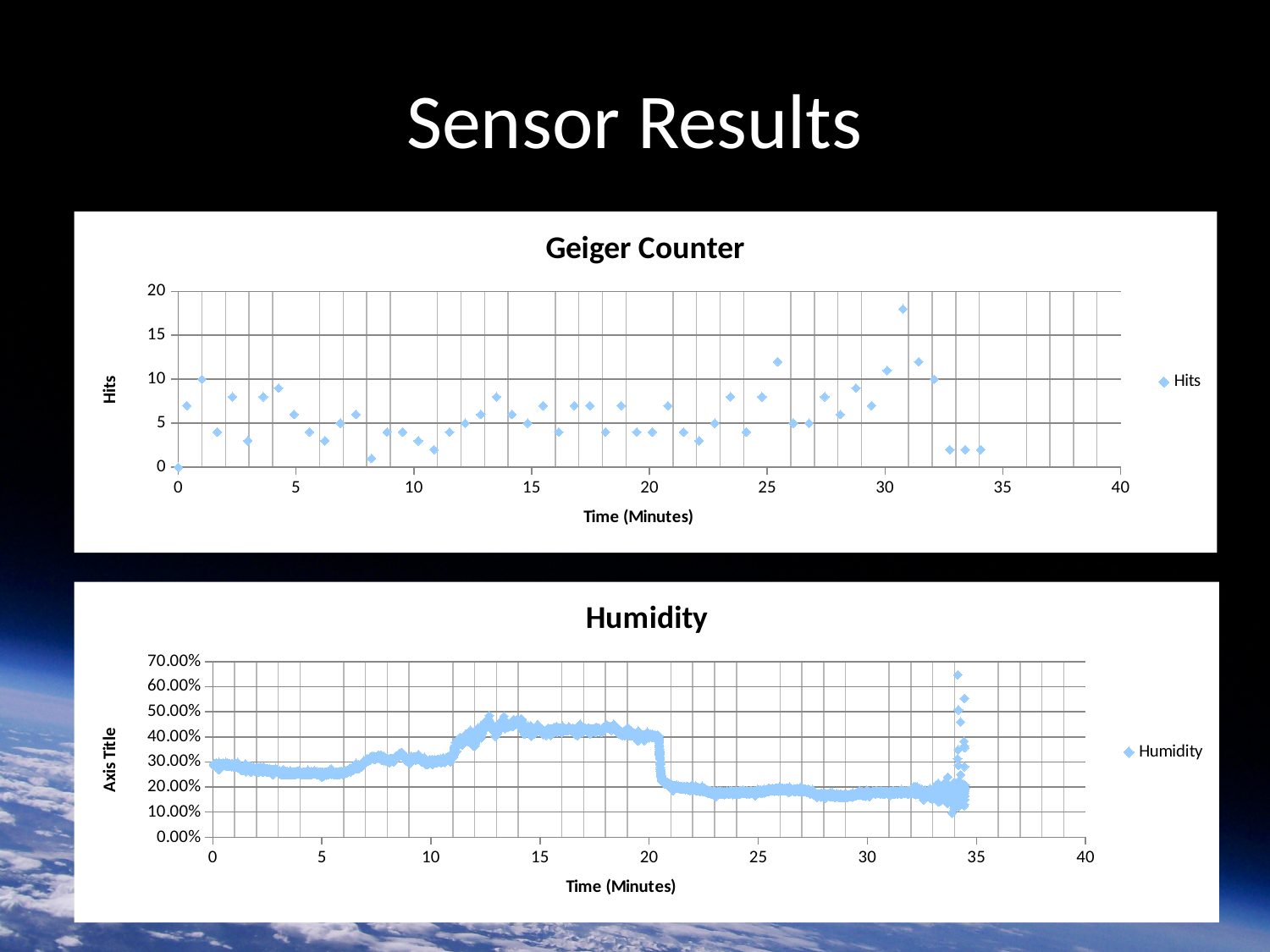
In the Humidity chart, is the humidity at around 5 minutes greater or less than 40.00%? less How many series does the legend of the Humidity chart list? 1 In the Humidity chart, does the humidity rise or fall between 20 and 21 minutes? fall In the Humidity chart, is the humidity at around 28 minutes greater or less than 20.00%? less What is the label on the vertical axis of the Geiger Counter chart? Hits How many series does the legend of the Geiger Counter chart list? 1 In the Geiger Counter chart, is the highest number of hits greater or less than 15? greater What is the label on the horizontal axis of the Humidity chart? Time (Minutes) What kind of chart is the Humidity chart? scatter chart What kind of chart is the Geiger Counter chart? scatter chart